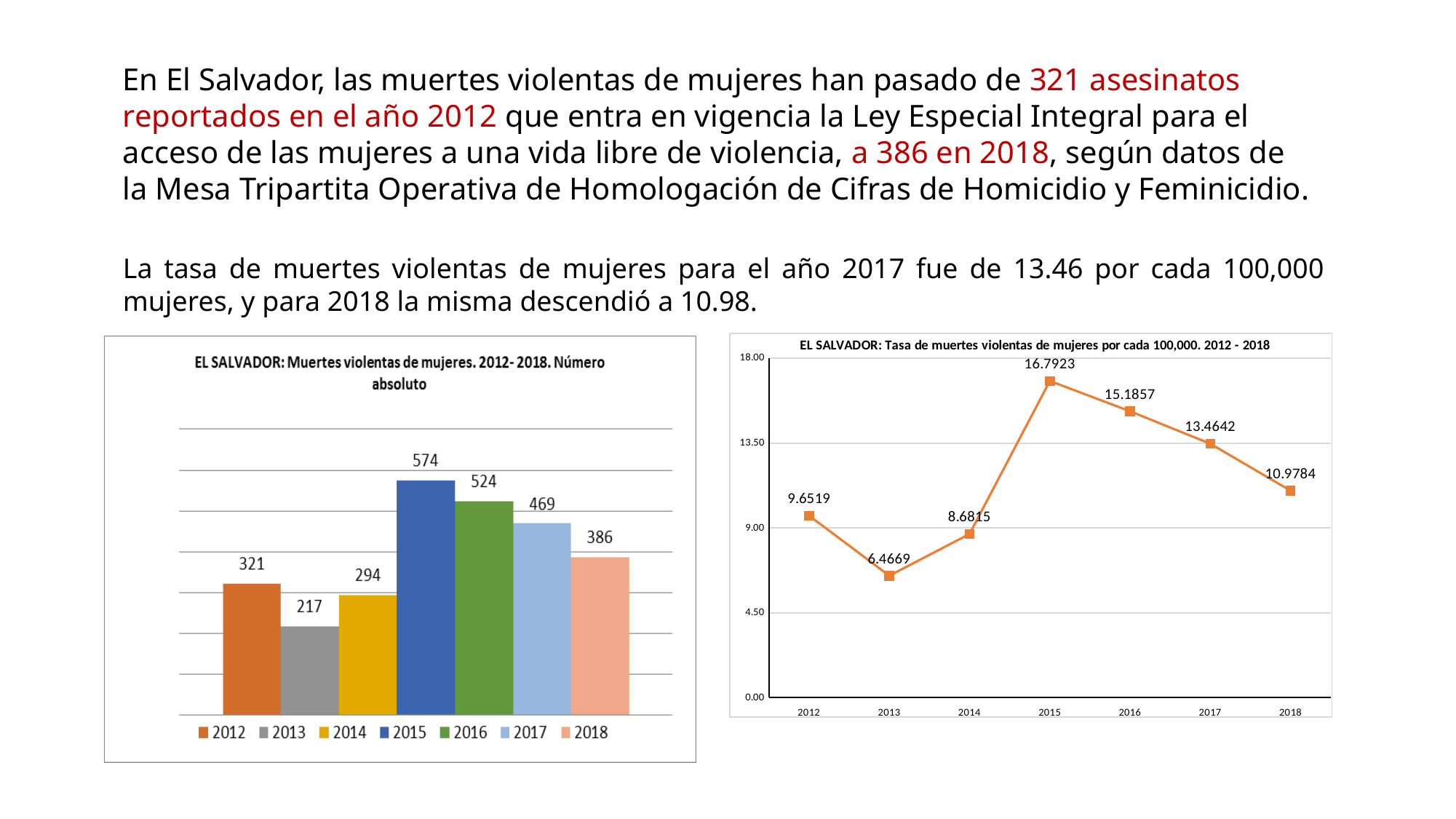
In the left chart (Muertes violentas de mujeres, número absoluto), how many years are shown? 7 In the left chart (Muertes violentas de mujeres, número absoluto), what is the value for 2015? 574 In the right chart (Tasa de muertes violentas de mujeres por cada 100,000), do the values rise or fall from 2015 to 2018? Fall What kind of chart is the left chart (Muertes violentas de mujeres, número absoluto)? Bar chart In the right chart (Tasa de muertes violentas de mujeres por cada 100,000), what is the value for 2015? 16.7923 In the left chart (Muertes violentas de mujeres, número absoluto), which year has the lowest value? 2013 In the right chart (Tasa de muertes violentas de mujeres por cada 100,000), which year has the lowest value? 2013 In the left chart (Muertes violentas de mujeres, número absoluto), what is the value for 2013? 217 In the right chart (Tasa de muertes violentas de mujeres por cada 100,000), what is the value for 2018? 10.9784 In the left chart (Muertes violentas de mujeres, número absoluto), what is the difference between the values for 2015 and 2018? 188 What kind of chart is the right chart (Tasa de muertes violentas de mujeres por cada 100,000)? Line chart In the left chart (Muertes violentas de mujeres, número absoluto), which year has the highest value? 2015